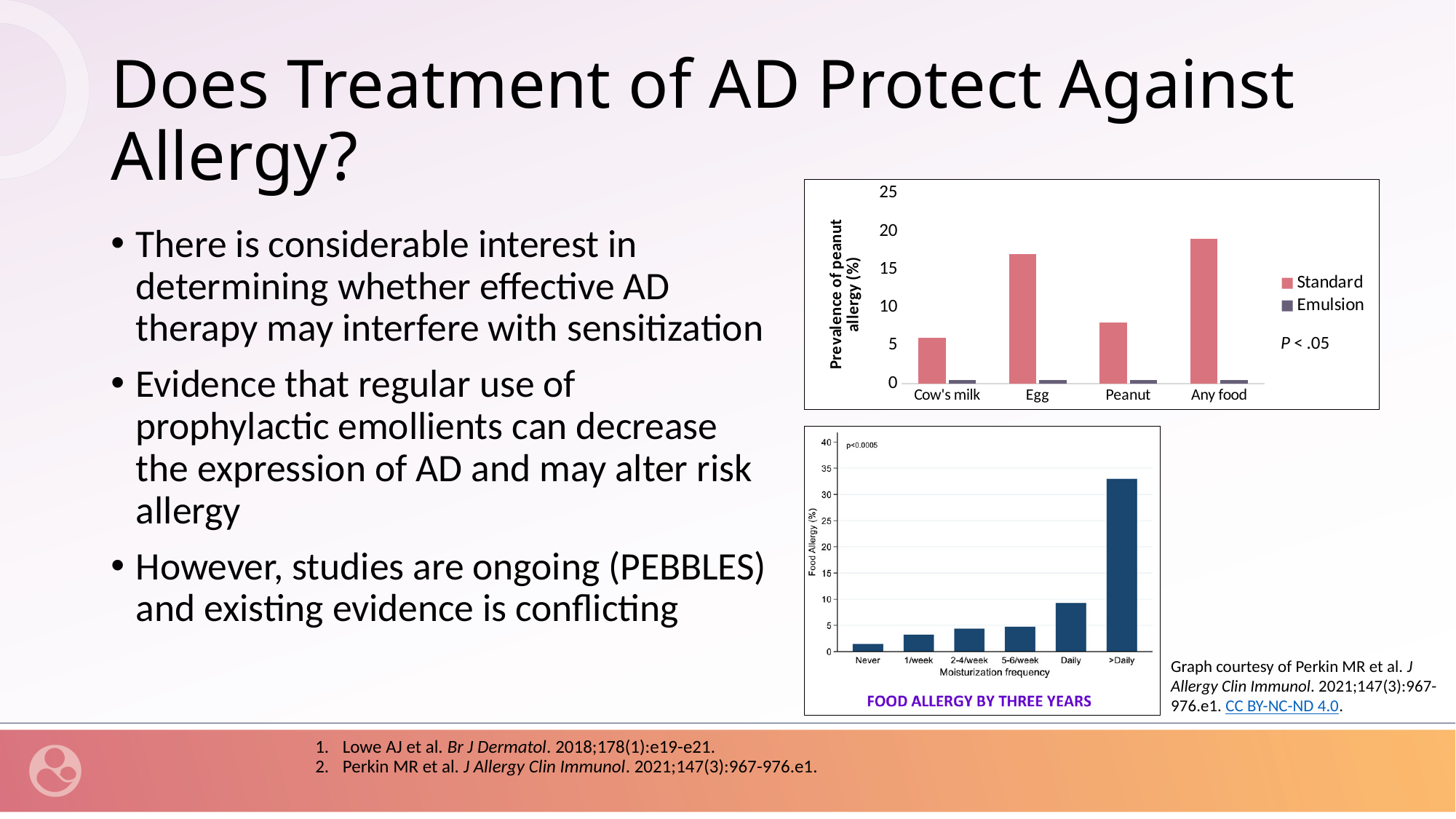
How many series does the legend of the top chart (Prevalence of peanut allergy) list? 2 In the top chart (Prevalence of peanut allergy), which category has the lowest Standard value? Cow's milk In the bottom chart (Food Allergy by Three Years), do the values rise or fall as moisturization frequency increases from Never to >Daily? rise In the bottom chart (Food Allergy by Three Years), which moisturization frequency has the highest food allergy percentage? >Daily In the top chart (Prevalence of peanut allergy), which is larger for Egg: the Standard value or the Emulsion value? Standard In the bottom chart (Food Allergy by Three Years), which moisturization frequency has the lowest food allergy percentage? Never In the bottom chart (Food Allergy by Three Years), is the value for >Daily greater or less than 30? greater In the top chart (Prevalence of peanut allergy), is the Standard value for Egg greater or less than 15? greater In the top chart (Prevalence of peanut allergy), which category has the highest Standard value? Any food In the top chart (Prevalence of peanut allergy), is the Standard value for Peanut greater or less than 10? less How many categories are shown on the x axis of the top chart (Prevalence of peanut allergy)? 4 What kind of chart is the bottom chart (Food Allergy by Three Years)? bar chart